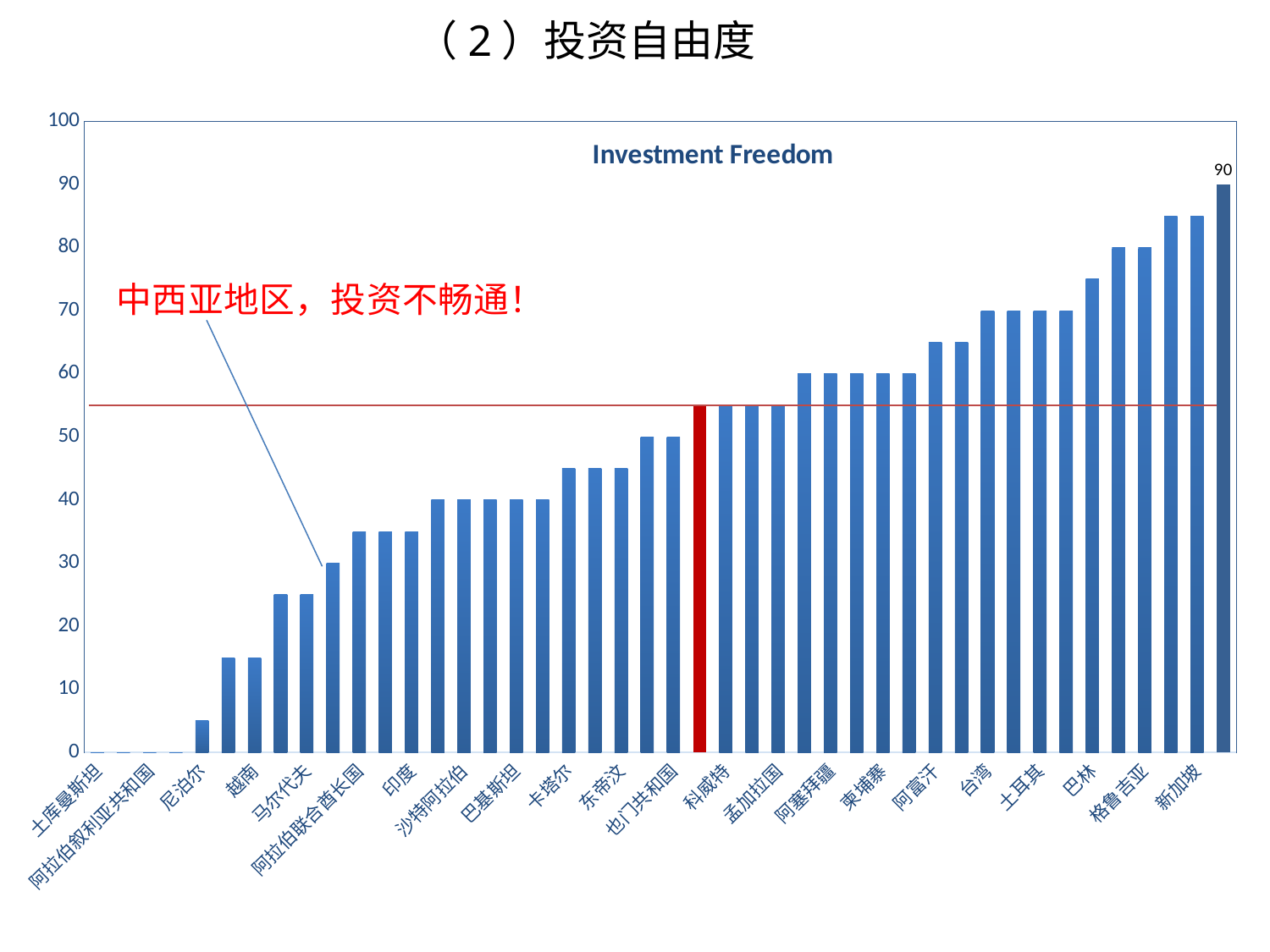
Is the value for 印度 greater or less than 50? less What colour is the single highlighted bar that differs from the other bars? red Is the value for 土库曼斯坦 greater or less than 10? less What is the title printed inside the chart area? Investment Freedom Which has a larger value, 新加坡 or 土库曼斯坦? 新加坡 Is the value for 尼泊尔 greater or less than 10? less What kind of chart is shown on the slide? bar chart Do the bar values rise or fall from left to right along the x axis? rise